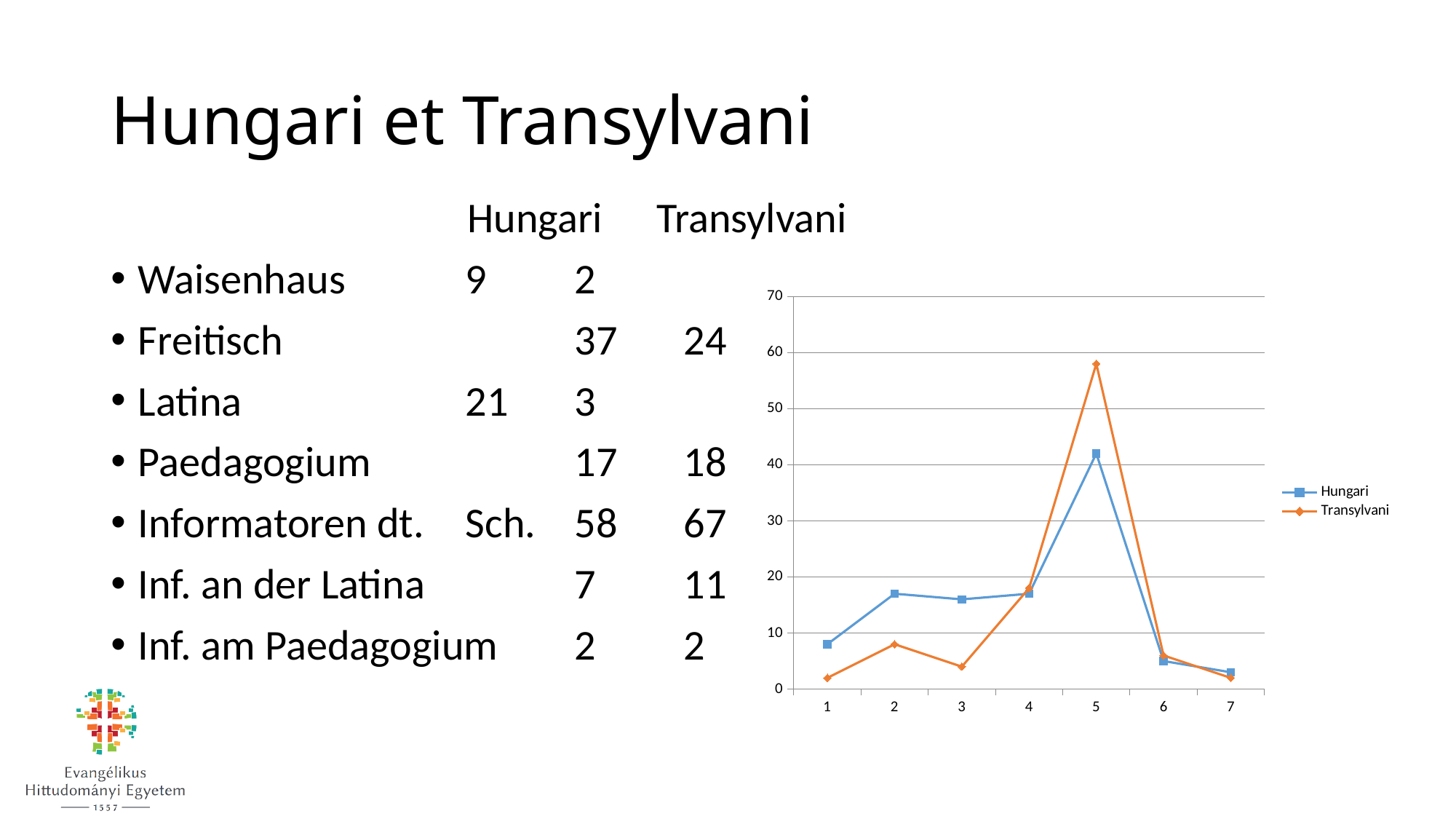
At which x-axis category is the Hungari series at its lowest value? 7 At which x-axis category does the Hungari series reach its highest value? 5 Is the value for Hungari at category 5 greater or less than 50? less At which x-axis category does the Transylvani series reach its highest value? 5 How many points are plotted along the x axis for each series? 7 At category 5, which series has the larger value, Hungari or Transylvani? Transylvani Is the value for Transylvani at category 5 greater or less than 50? greater Do the values of both series rise or fall from category 5 to category 6? fall How many series does the chart's legend list? 2 Is the value for Transylvani at category 3 greater or less than 10? less At category 1, which series has the larger value, Hungari or Transylvani? Hungari What kind of chart is shown on the slide? line chart